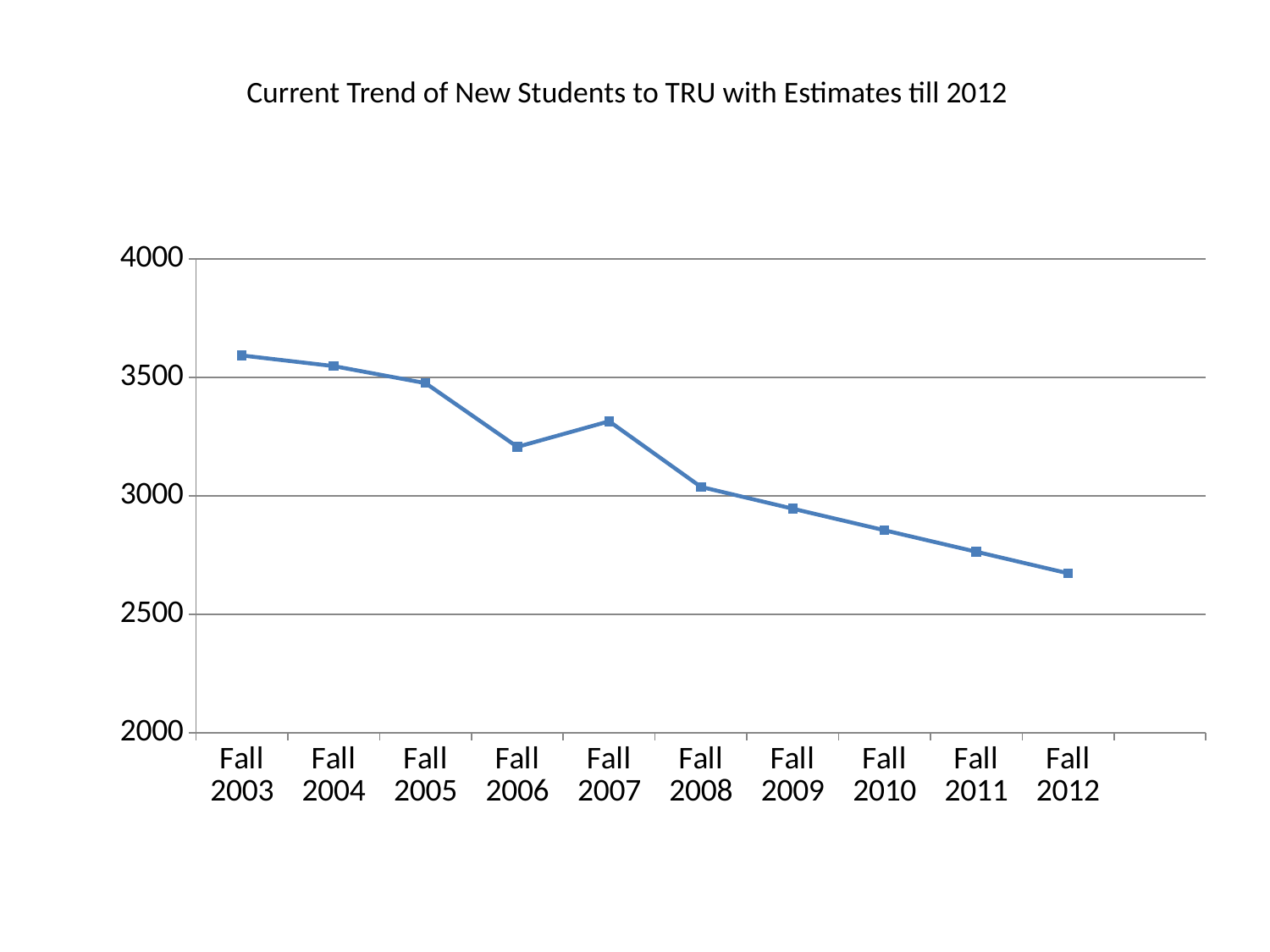
Is the value for Fall 2007 greater or less than 3000? greater Is the value for Fall 2009 greater or less than 3000? less What is the title of the chart? Current Trend of New Students to TRU with Estimates till 2012 Is the value for Fall 2006 greater or less than 3500? less Which term has the lowest number of new students? Fall 2012 Which is larger, the value for Fall 2005 or the value for Fall 2008? Fall 2005 Which is larger, the value for Fall 2006 or the value for Fall 2007? Fall 2007 What kind of chart is shown on the slide? line chart Overall, do the values rise or fall from Fall 2003 to Fall 2012? fall How many data points are plotted on the line? 10